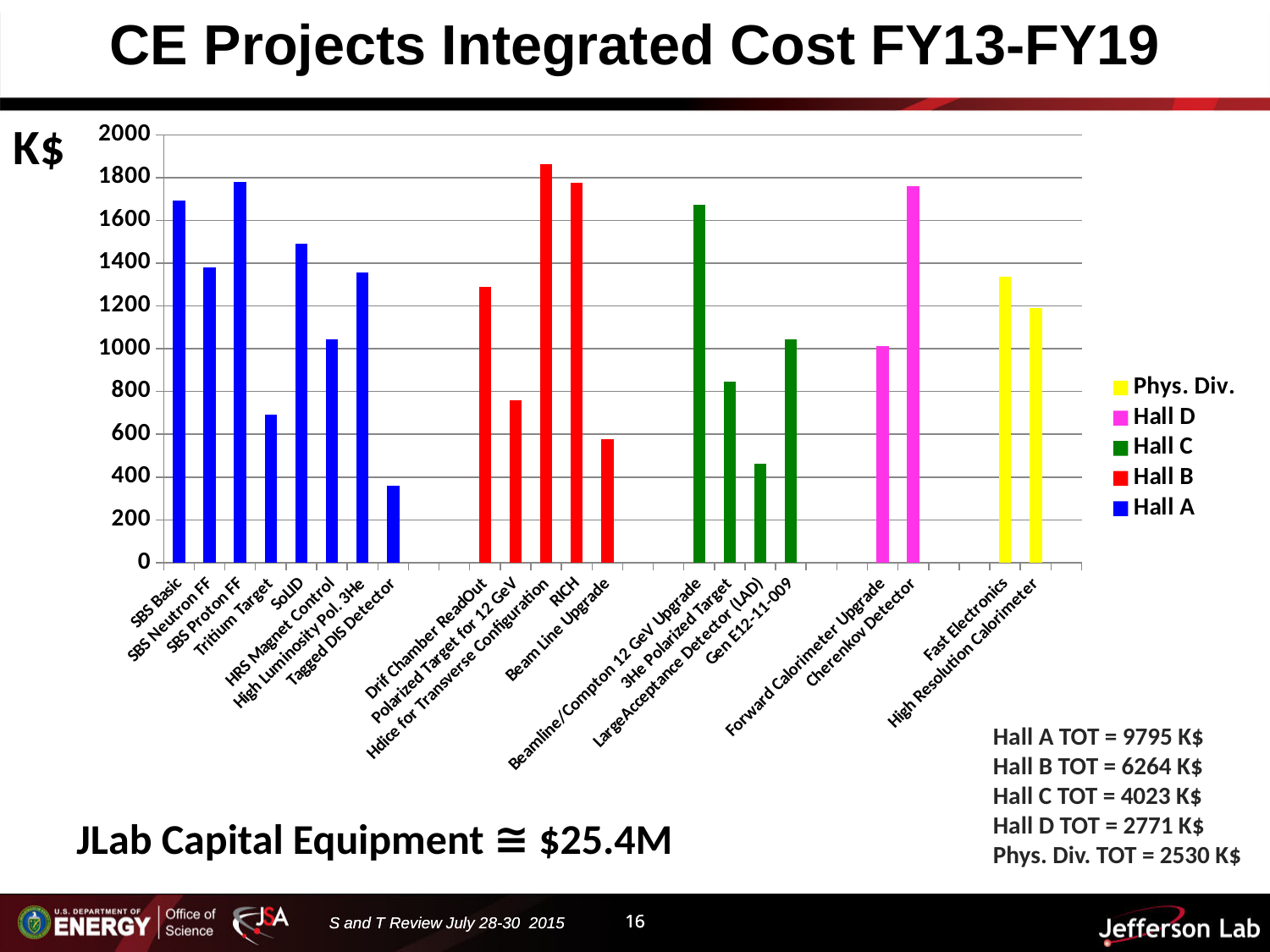
Which project has the lowest integrated cost? Tagged DIS Detector Is the value for Cherenkov Detector greater or less than 1600? greater How many project categories are plotted along the x axis? 21 Is the value for Tritium Target greater or less than 800? less Is the value for Large Acceptance Detector (LAD) greater or less than 600? less Which is larger, the value for SBS Basic or SBS Neutron FF? SBS Basic Which project has the highest integrated cost? Hdice for Transverse Configuration Which is larger, the value for Forward Calorimeter Upgrade or Cherenkov Detector? Cherenkov Detector What colour are the Hall B bars in the chart? red What kind of chart is shown on the slide? bar chart How many series does the legend list? 5